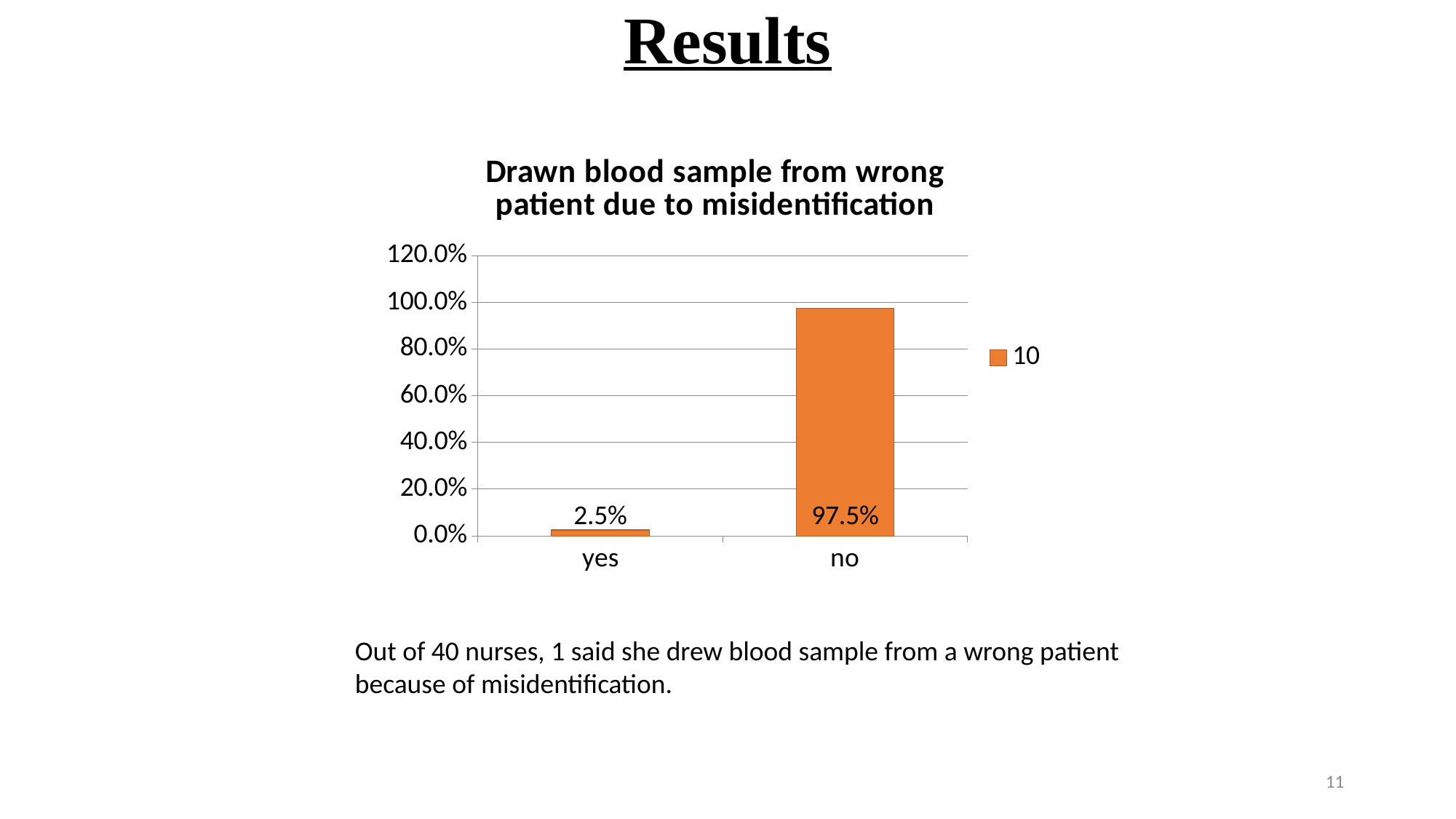
What is the value for "no"? 97.5% How many series does the legend list? 1 Is the value for "yes" greater or less than 20.0%? less Which is larger, the value for "yes" or the value for "no"? no What is the value for "yes"? 2.5% What is the title of the chart? Drawn blood sample from wrong patient due to misidentification Which category has the highest value? no What kind of chart is shown? bar chart Is the value for "no" greater or less than 80.0%? greater How many categories are shown on the x axis? 2 What is the difference between the values for "no" and "yes"? 95% Which category has the lowest value? yes